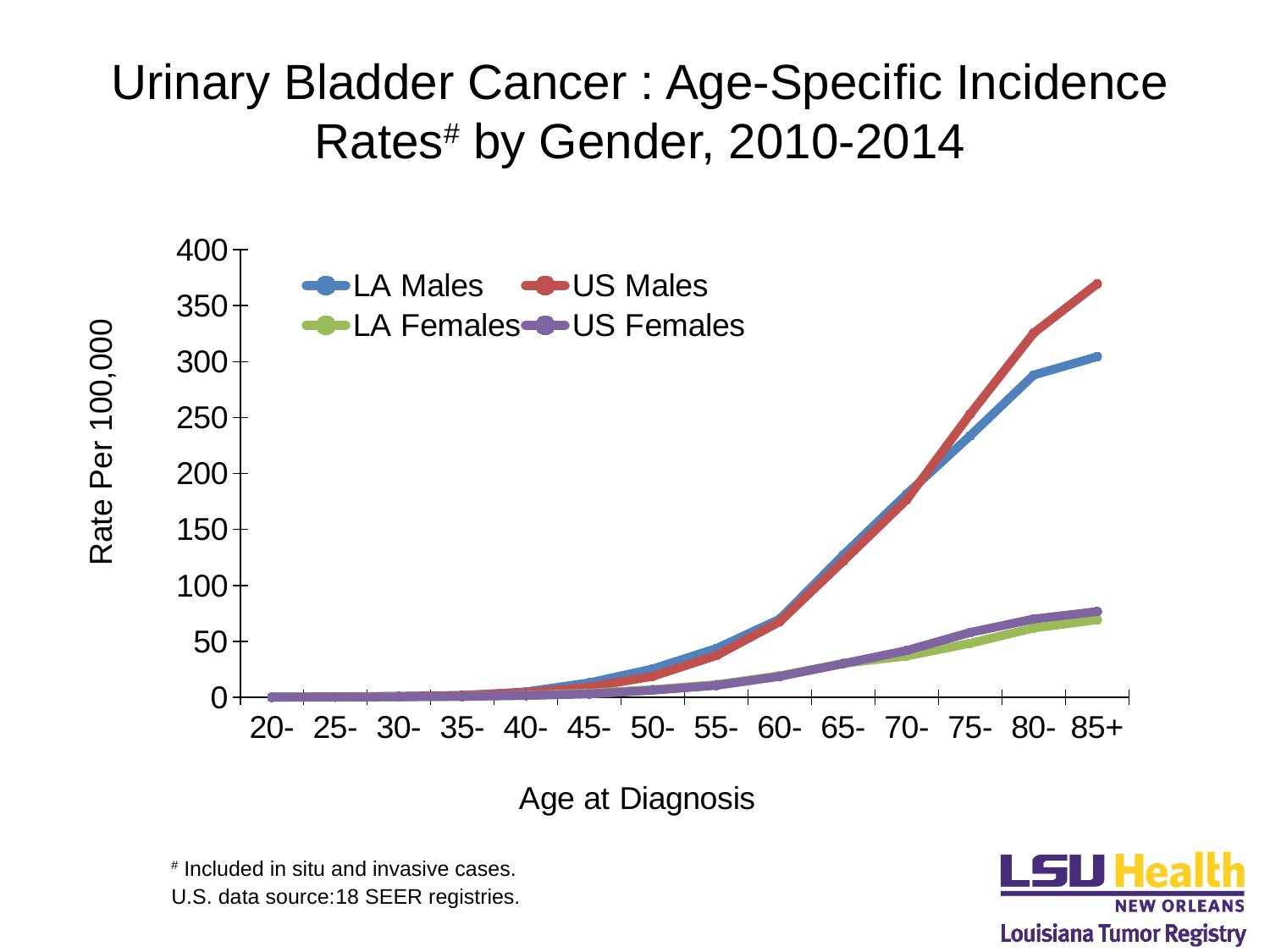
Is the value for LA Males at age 85+ greater or less than 250? greater How many age groups are shown along the x axis? 14 Is the value for US Males at age 85+ greater or less than 350? greater Is the value for LA Females at age 85+ greater or less than 100? less At age 85+, which is larger: the value for US Males or the value for LA Males? US Males At age 80-, which is larger: the value for LA Males or the value for US Females? LA Males How many series does the legend list? 4 Do the values for US Males rise or fall as age at diagnosis increases? rise What kind of chart is shown on the slide? line chart Which series has the highest value at age 85+? US Males What is the label of the y axis? Rate Per 100,000